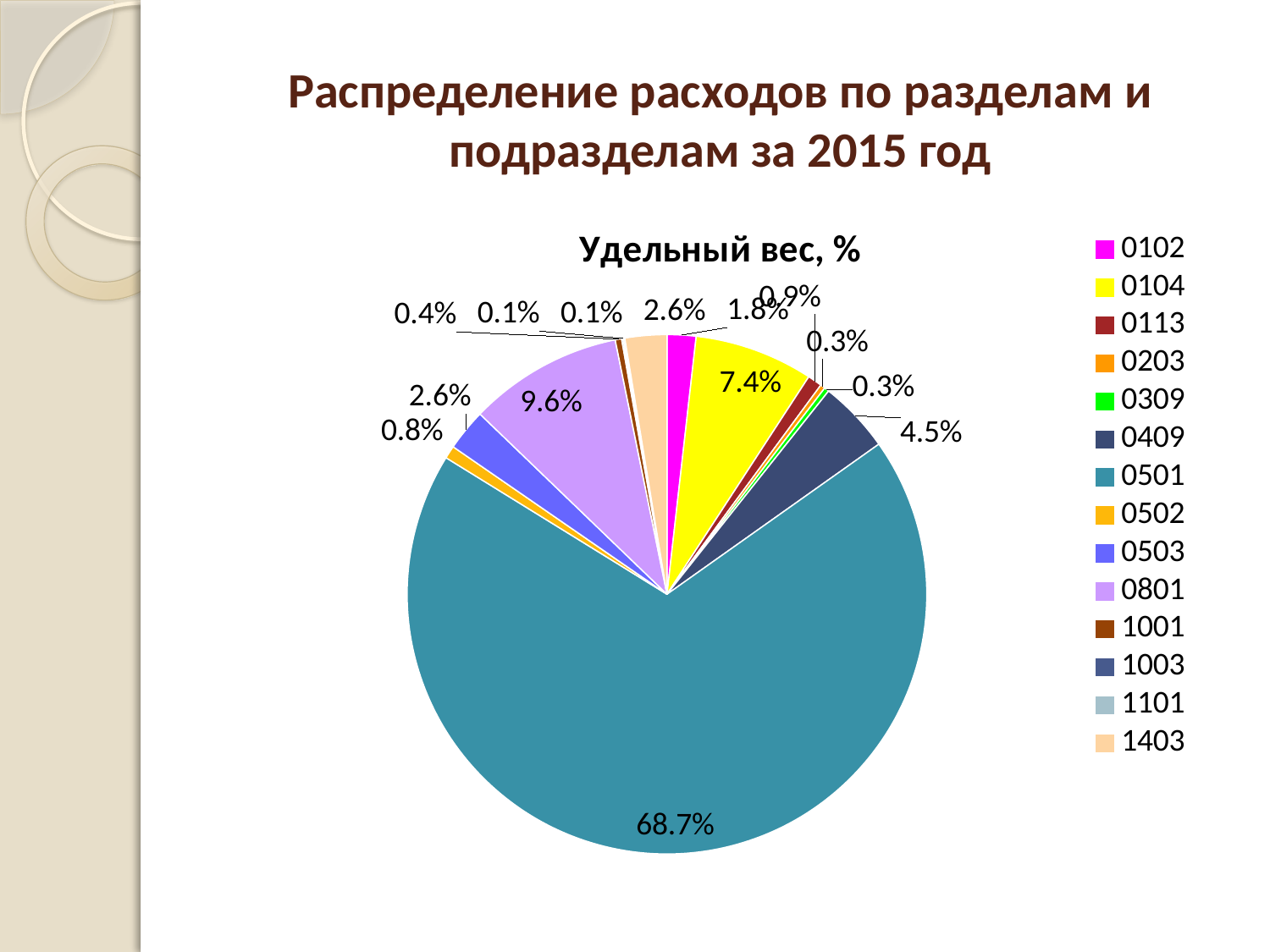
What kind of chart is shown on the slide? pie chart What is the value for category 0104? 7.4% What is the title of the chart? Удельный вес, % What is the difference between the shares of 0501 and 0801? 59.1% What is the value for category 0801? 9.6% Which category has the largest share in the pie chart? 0501 How many categories does the legend list? 14 What is the difference between the shares of 0801 and 0104? 2.2% What is the value for category 0502? 0.8% What is the value for category 0102? 1.8% Which is larger, the share of 0104 or the share of 0801? 0801 What is the share of category 0501? 68.7%